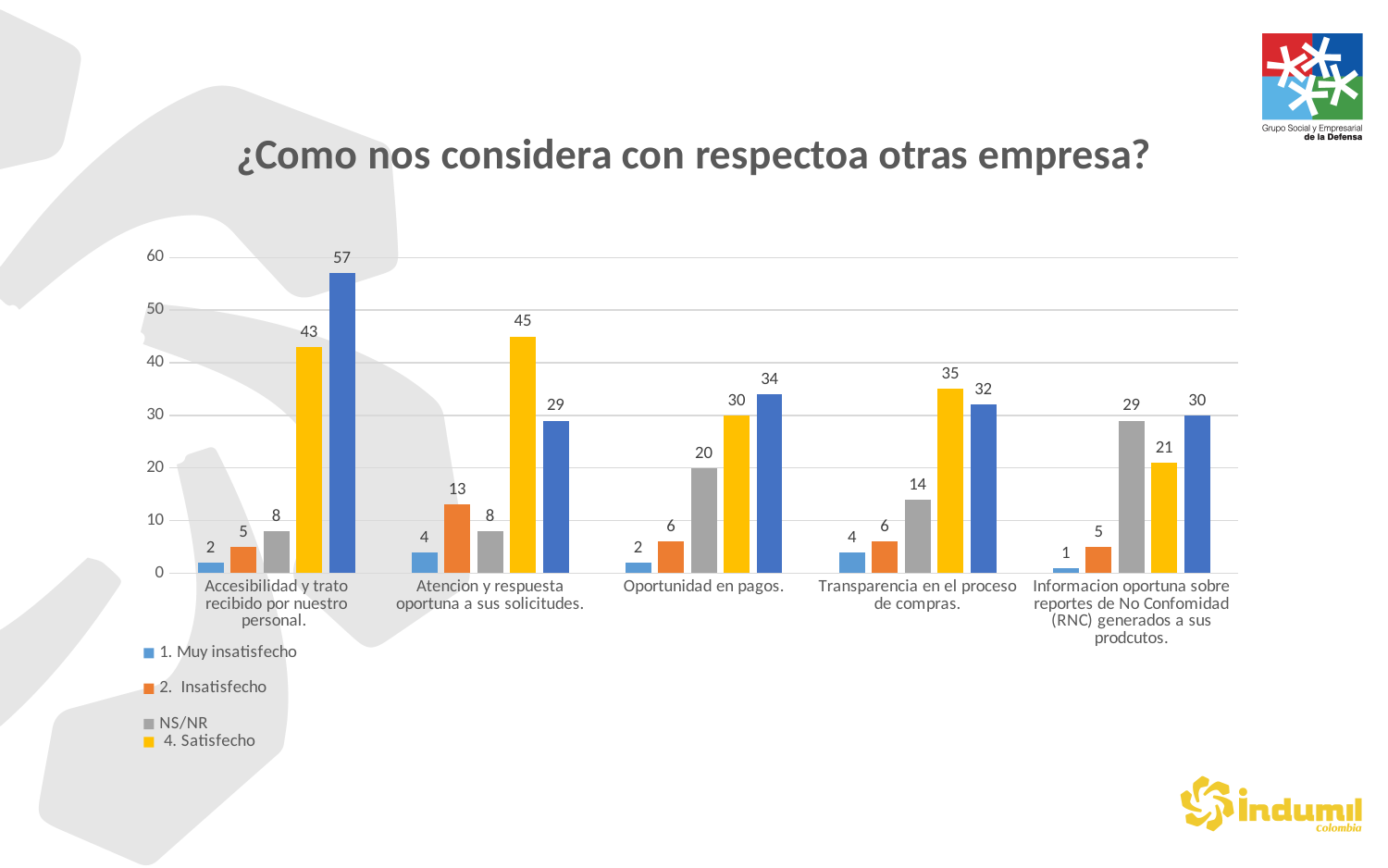
What is the difference between the '4. Satisfecho' value and the 'NS/NR' value in the 'Transparencia en el proceso de compras.' category? 21 How many series does the legend list? 4 What is the title of the chart? ¿Como nos considera con respectoa otras empresa? Which is larger in the 'Informacion oportuna sobre reportes de No Confomidad (RNC) generados a sus prodcutos.' category: 'NS/NR' or '4. Satisfecho'? NS/NR What is the value for '4. Satisfecho' in the 'Accesibilidad y trato recibido por nuestro personal.' category? 43 What kind of chart is shown on the slide? Bar chart What is the value for '1. Muy insatisfecho' in the 'Informacion oportuna sobre reportes de No Confomidad (RNC) generados a sus prodcutos.' category? 1 What is the value for '2. Insatisfecho' in the 'Atencion y respuesta oportuna a sus solicitudes.' category? 13 How many categories are shown on the x axis? 5 What is the value for 'NS/NR' in the 'Oportunidad en pagos.' category? 20 Which category has the highest value for '4. Satisfecho'? Atencion y respuesta oportuna a sus solicitudes.